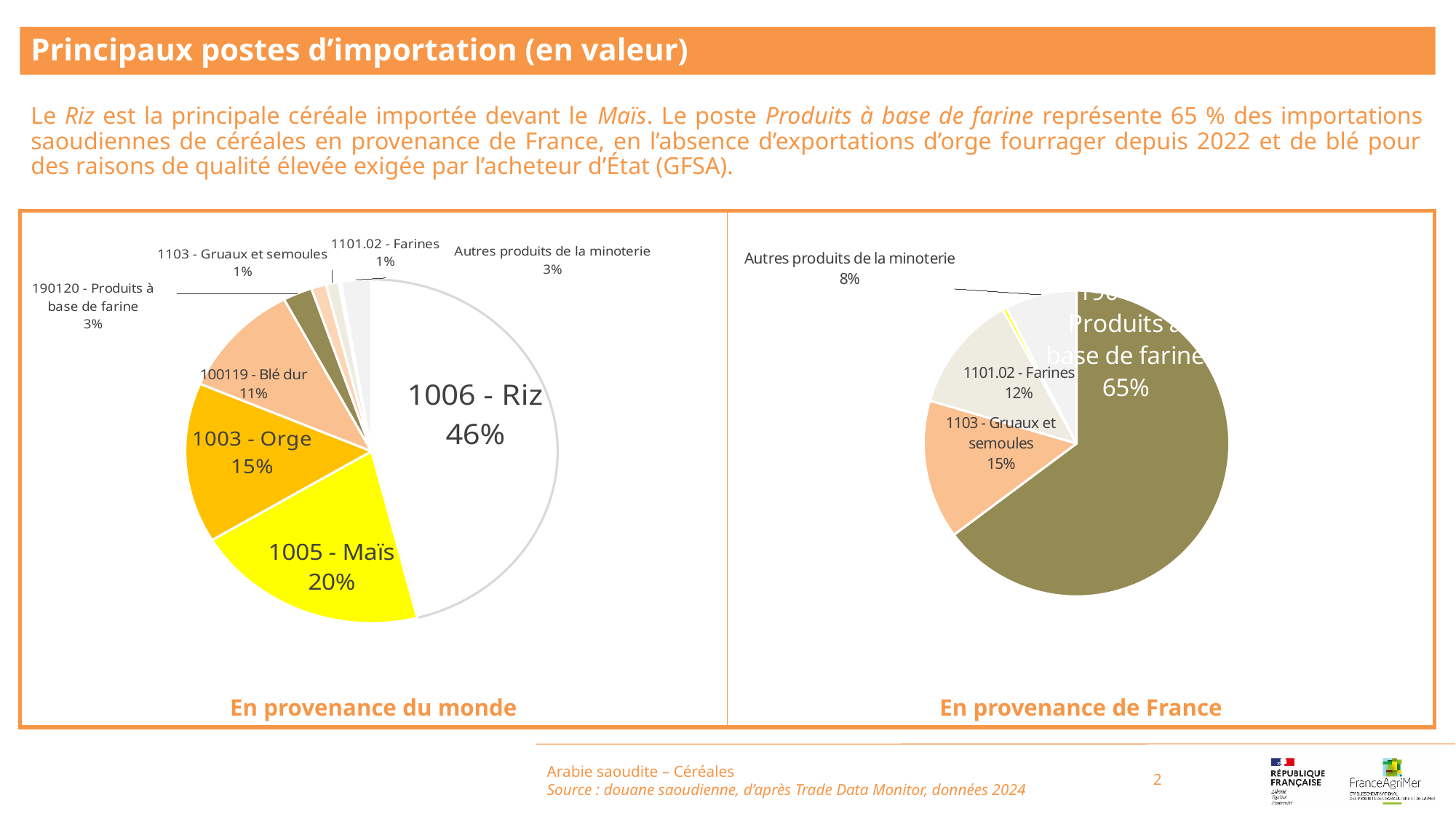
In the 'En provenance du monde' pie chart, what share does 1006 - Riz represent? 46% In the 'En provenance de France' pie chart, what is the share of 1101.02 - Farines? 12% In the 'En provenance de France' pie chart, what is the difference in percentage points between 1103 - Gruaux et semoules and Autres produits de la minoterie? 7 percentage points What is the title of the slide containing the two pie charts? Principaux postes d’importation (en valeur) In the 'En provenance du monde' pie chart, what is the difference in percentage points between 1006 - Riz and 1005 - Maïs? 26 percentage points In the 'En provenance de France' pie chart, what share does Produits à base de farine represent? 65% In the 'En provenance du monde' pie chart, what is the share of 100119 - Blé dur? 11% In the 'En provenance du monde' pie chart, which category has the largest share? 1006 - Riz How many slices are labelled in the 'En provenance du monde' pie chart? 8 In the 'En provenance du monde' pie chart, what share does 1005 - Maïs represent? 20% What kind of chart is used in the 'En provenance du monde' panel? Pie chart In the 'En provenance du monde' pie chart, which is larger: 1003 - Orge or 100119 - Blé dur? 1003 - Orge